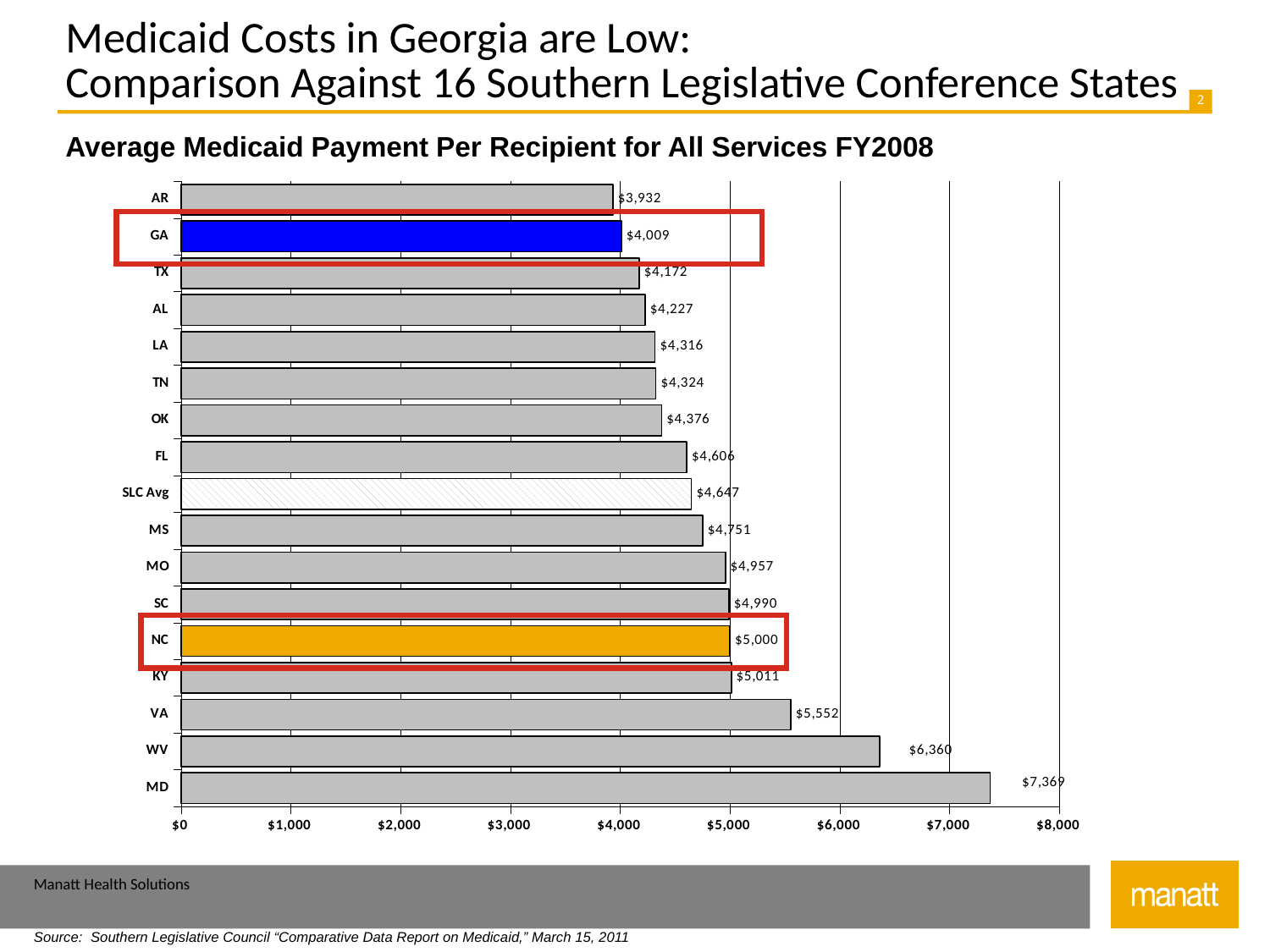
How many bars are shown in the chart? 17 What is the average Medicaid payment per recipient for NC? $5,000 What is the value shown for the SLC Avg bar? $4,647 Is the value for MD greater or less than $7,000? greater What is the title of the chart? Average Medicaid Payment Per Recipient for All Services FY2008 What is the difference between the values for NC and GA? $991 What is the value shown for WV? $6,360 Which state has the lowest average Medicaid payment per recipient? AR What is the average Medicaid payment per recipient for GA? $4,009 Which has a larger value, VA or KY? VA Which state has the highest average Medicaid payment per recipient? MD What kind of chart is shown on the slide? Bar chart